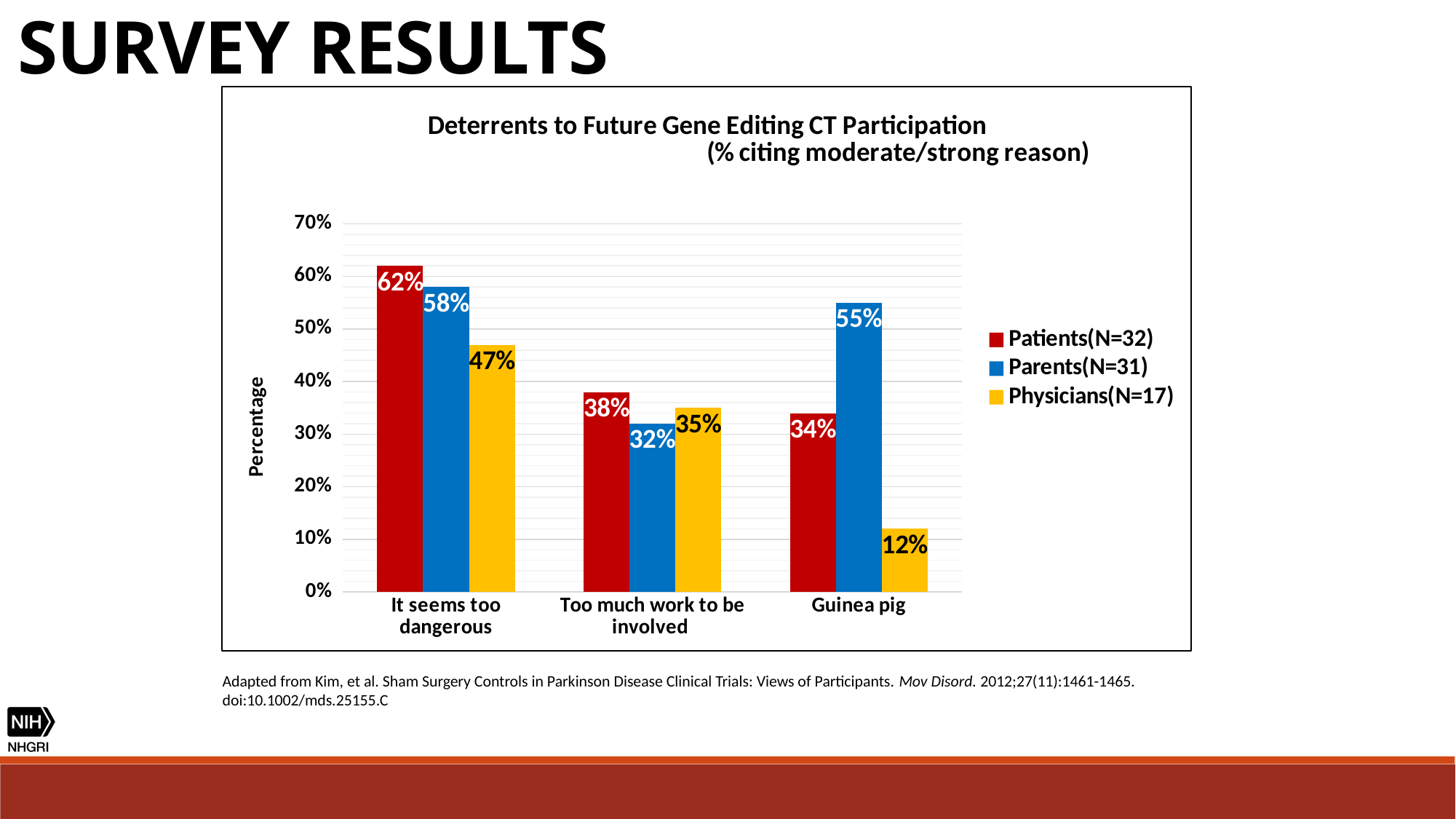
What is the label on the y axis? Percentage What is the title of the chart? Deterrents to Future Gene Editing CT Participation (% citing moderate/strong reason) What is the difference between the Patients(N=32) and Physicians(N=17) values for 'It seems too dangerous'? 15% What percentage of Patients(N=32) cited 'It seems too dangerous' as a moderate/strong reason? 62% What is the value for Parents(N=31) in the 'Too much work to be involved' category? 32% Which group has the highest value for 'Guinea pig'? Parents(N=31) Which is larger: the Patients(N=32) value for 'Too much work to be involved' or the Physicians(N=17) value for the same category? Patients(N=32) Which group has the lowest value for 'It seems too dangerous'? Physicians(N=17) What kind of chart is shown on the slide? Bar chart How many categories are shown on the x axis? 3 How many series does the legend list? 3 What is the value for Physicians(N=17) in the 'Guinea pig' category? 12%